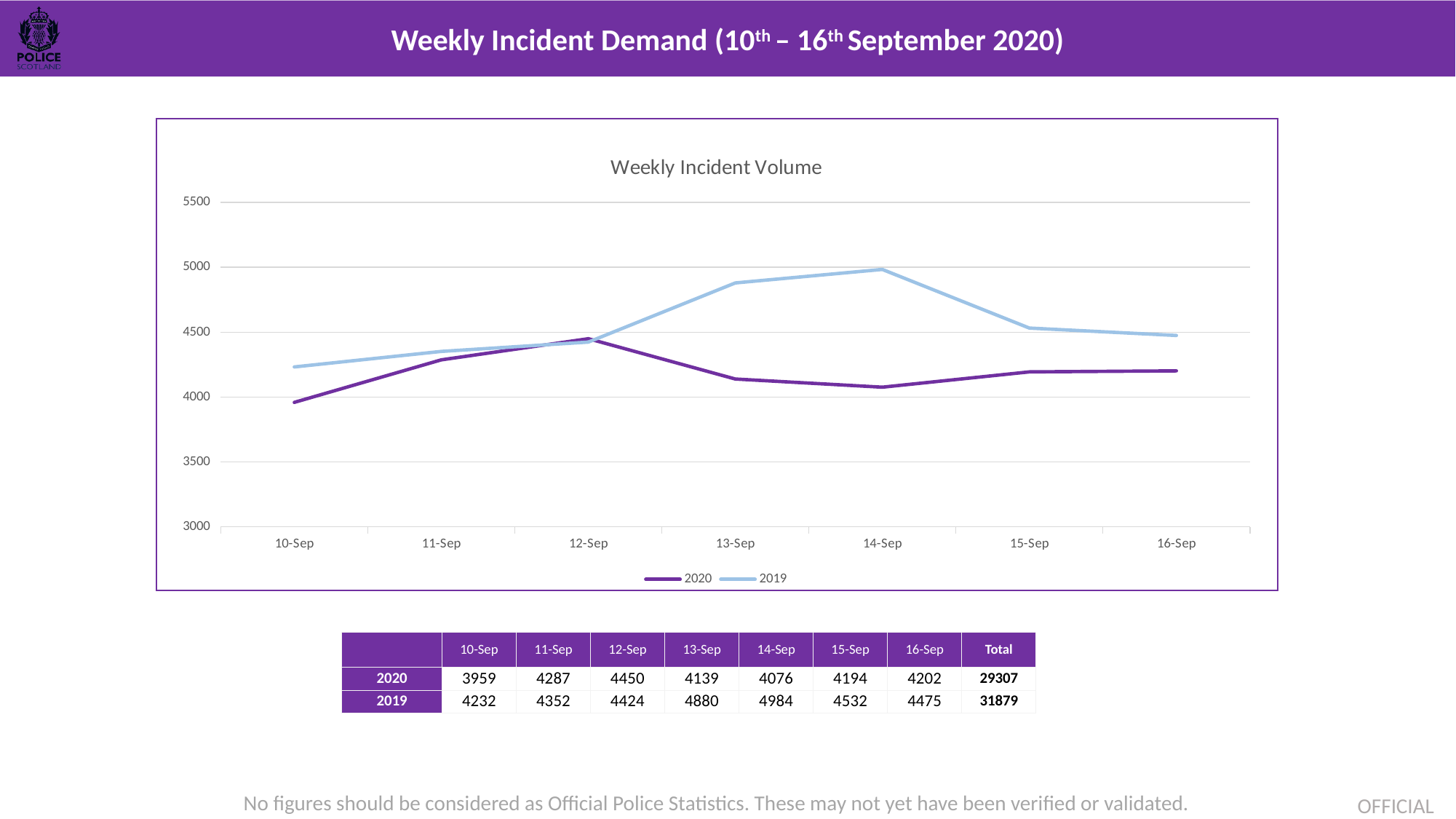
How many series does the chart legend list? 2 Is the 2020 value on 10-Sep greater or less than 4000? less How many dates are plotted along the x axis of the chart? 7 What is the 2019 incident volume on 14-Sep? 4984 What is the title of the chart? Weekly Incident Volume What is the difference between the 2019 and 2020 values on 13-Sep? 741 What is the 2020 incident volume on 12-Sep? 4450 Which series has the higher value on 12-Sep, 2020 or 2019? 2020 On which date is the 2020 series at its lowest? 10-Sep Does the 2020 series rise or fall from 12-Sep to 14-Sep? fall What type of chart is shown on the slide? line chart On which date is the 2019 series at its highest? 14-Sep